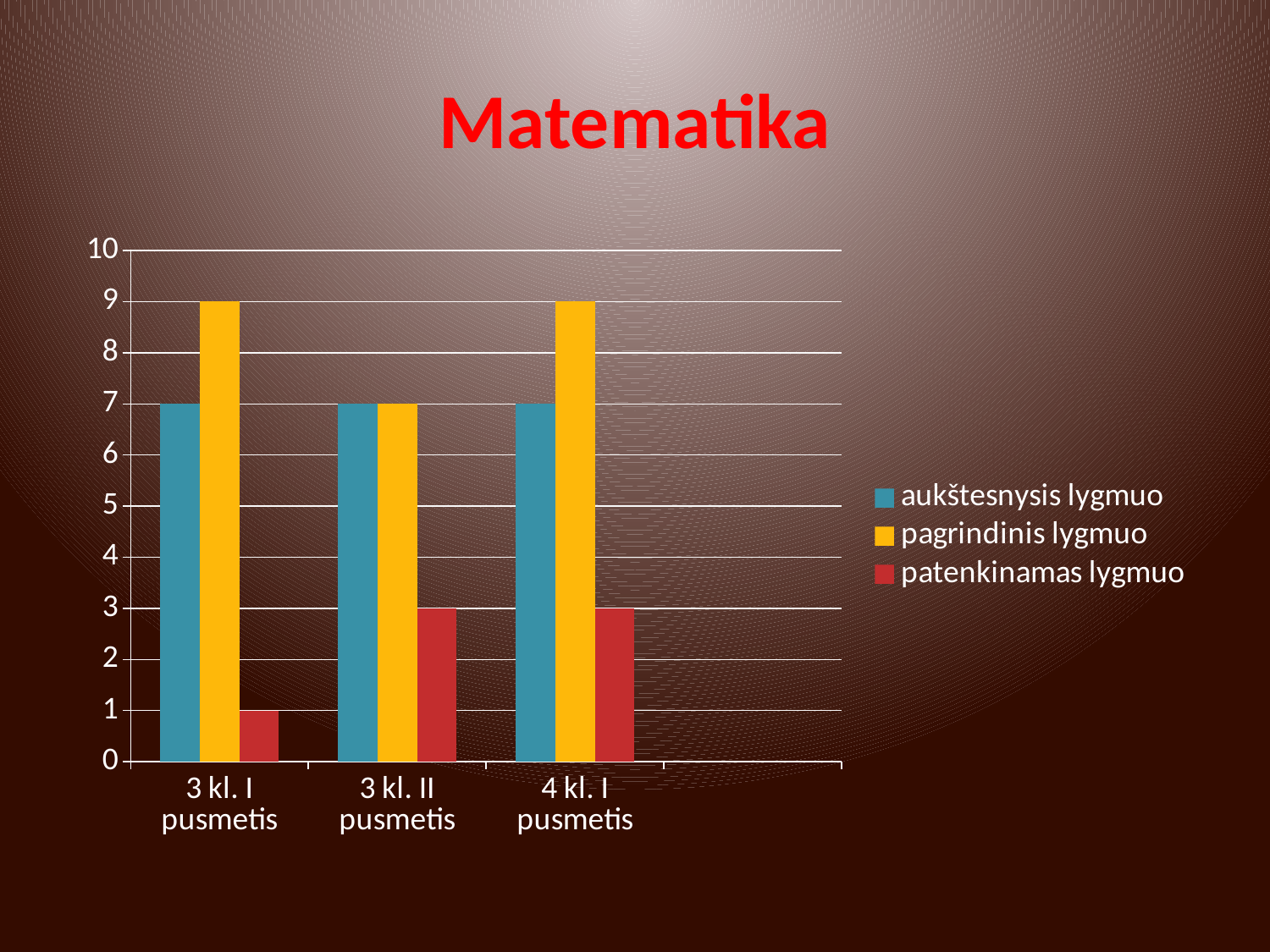
What is the title of the slide? Matematika Which is larger for 4 kl. I pusmetis: aukštesnysis lygmuo or pagrindinis lygmuo? pagrindinis lygmuo How many categories are shown on the x axis? 3 What kind of chart is shown on the slide? bar chart What is the value of patenkinamas lygmuo for 4 kl. I pusmetis? 3 What is the difference between pagrindinis lygmuo and patenkinamas lygmuo for 3 kl. I pusmetis? 8 How many series does the legend list? 3 What is the value of pagrindinis lygmuo for 3 kl. I pusmetis? 9 Which category has the lowest value for pagrindinis lygmuo? 3 kl. II pusmetis What is the value of aukštesnysis lygmuo for 3 kl. II pusmetis? 7 What is the value of patenkinamas lygmuo for 3 kl. I pusmetis? 1 Which category has the lowest value for patenkinamas lygmuo? 3 kl. I pusmetis